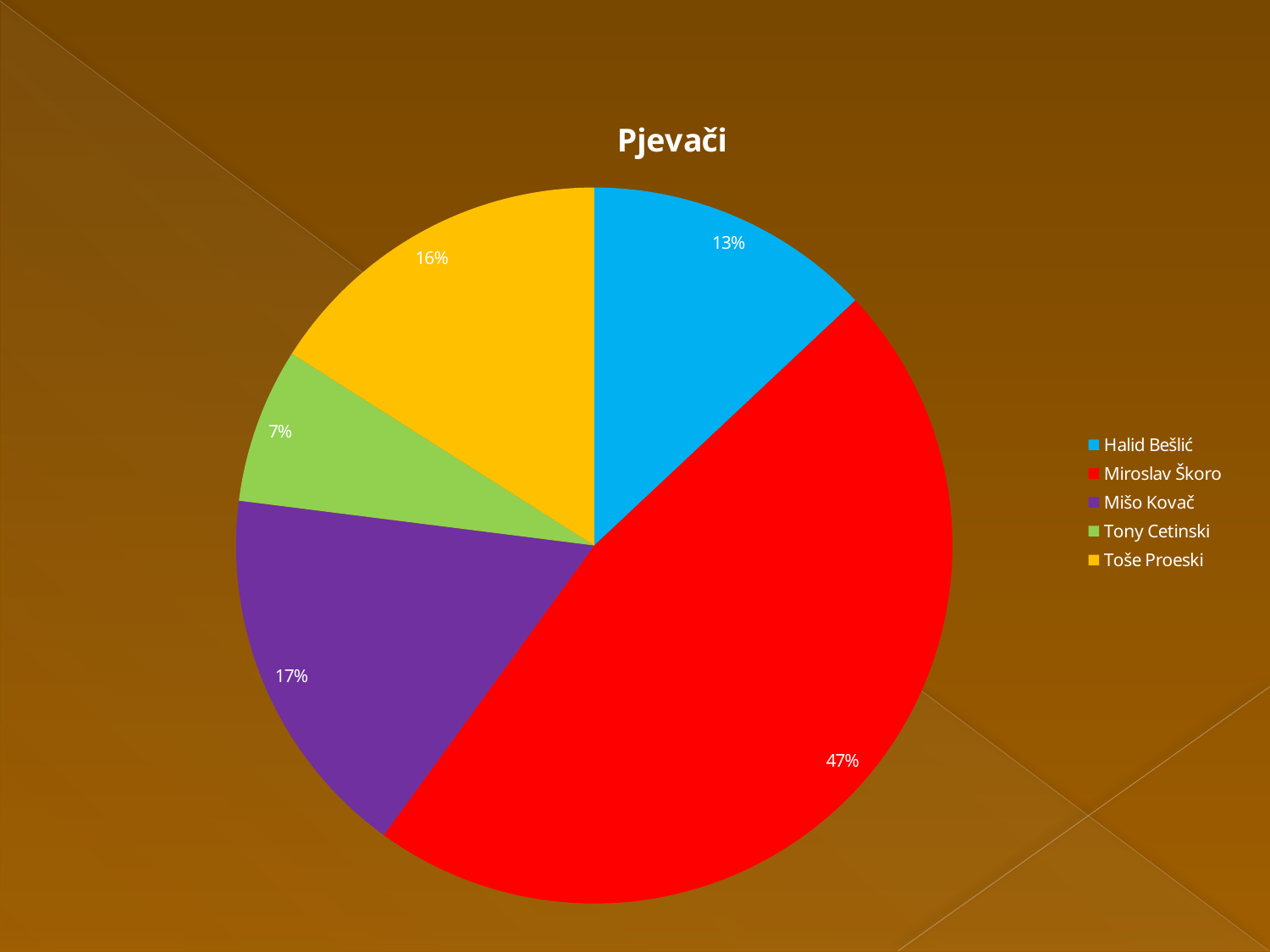
How many slices does the pie chart have? 5 What share of the pie does Halid Bešlić have? 13% What share of the pie does Mišo Kovač have? 17% What kind of chart is shown on the slide? pie chart What share of the pie does Miroslav Škoro have? 47% What is the difference in percentage points between Miroslav Škoro's share and Mišo Kovač's share? 30 Which slice is larger, Halid Bešlić or Toše Proeski? Toše Proeski Which singer has the smallest slice of the pie? Tony Cetinski What is the title of the chart? Pjevači Which singer has the largest slice of the pie? Miroslav Škoro